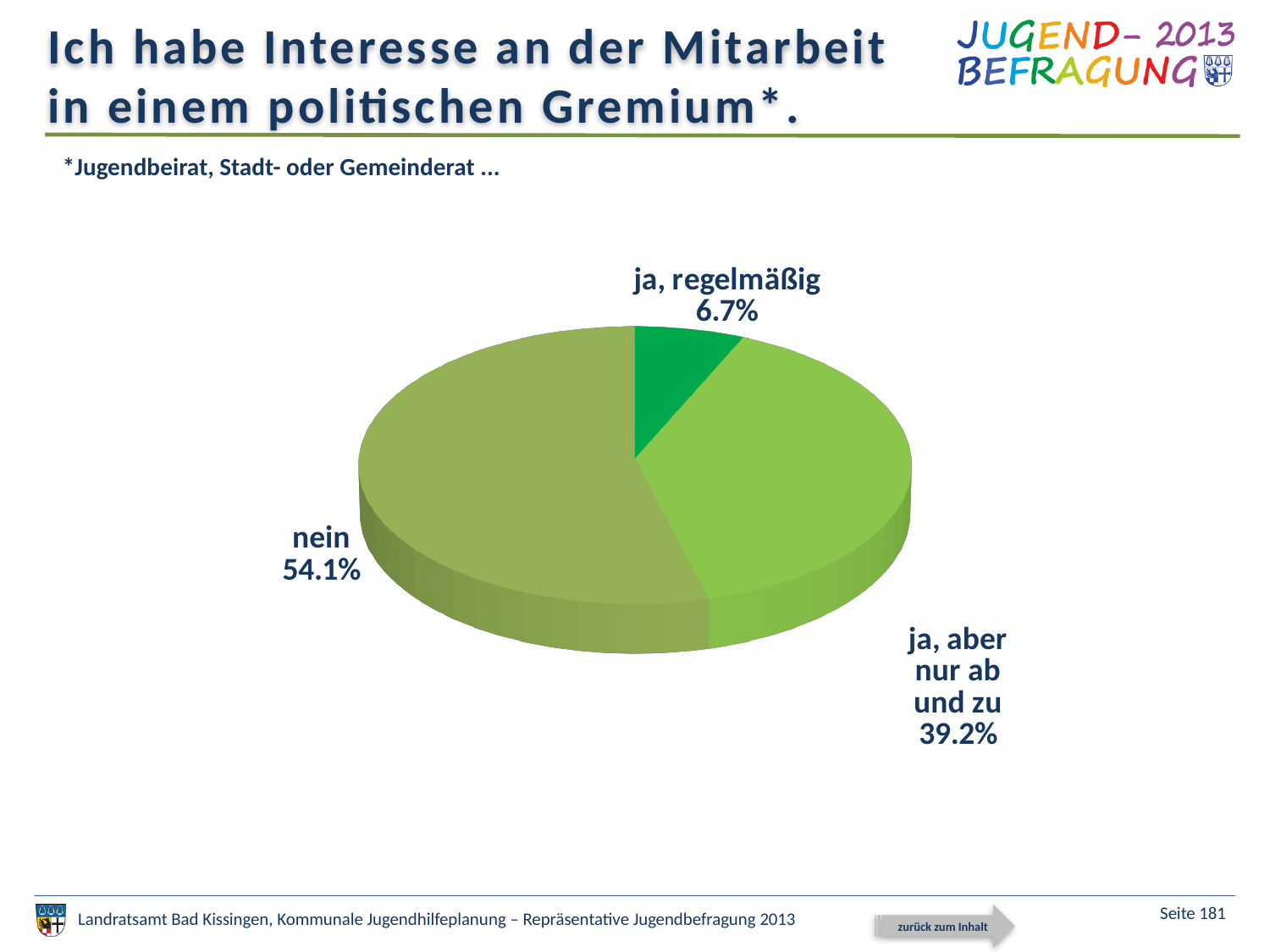
What is the difference in percentage points between "nein" and "ja, aber nur ab und zu"? 14.9 Which answer category has the largest share of the pie? nein Which answer category has the smallest share of the pie? ja, regelmäßig What percentage of respondents answered "ja, aber nur ab und zu"? 39.2% What is the combined share of the two "ja" answers ("ja, regelmäßig" and "ja, aber nur ab und zu")? 45.9% What does the footnote below the title say the asterisk refers to? Jugendbeirat, Stadt- oder Gemeinderat ... How many categories are shown in the pie chart? 3 What is the title of the slide containing the chart? Ich habe Interesse an der Mitarbeit in einem politischen Gremium*. What kind of chart is shown on the slide? pie chart What percentage of respondents answered "nein"? 54.1% What percentage of respondents answered "ja, regelmäßig"? 6.7% Which is larger: the share for "ja, aber nur ab und zu" or the share for "ja, regelmäßig"? ja, aber nur ab und zu